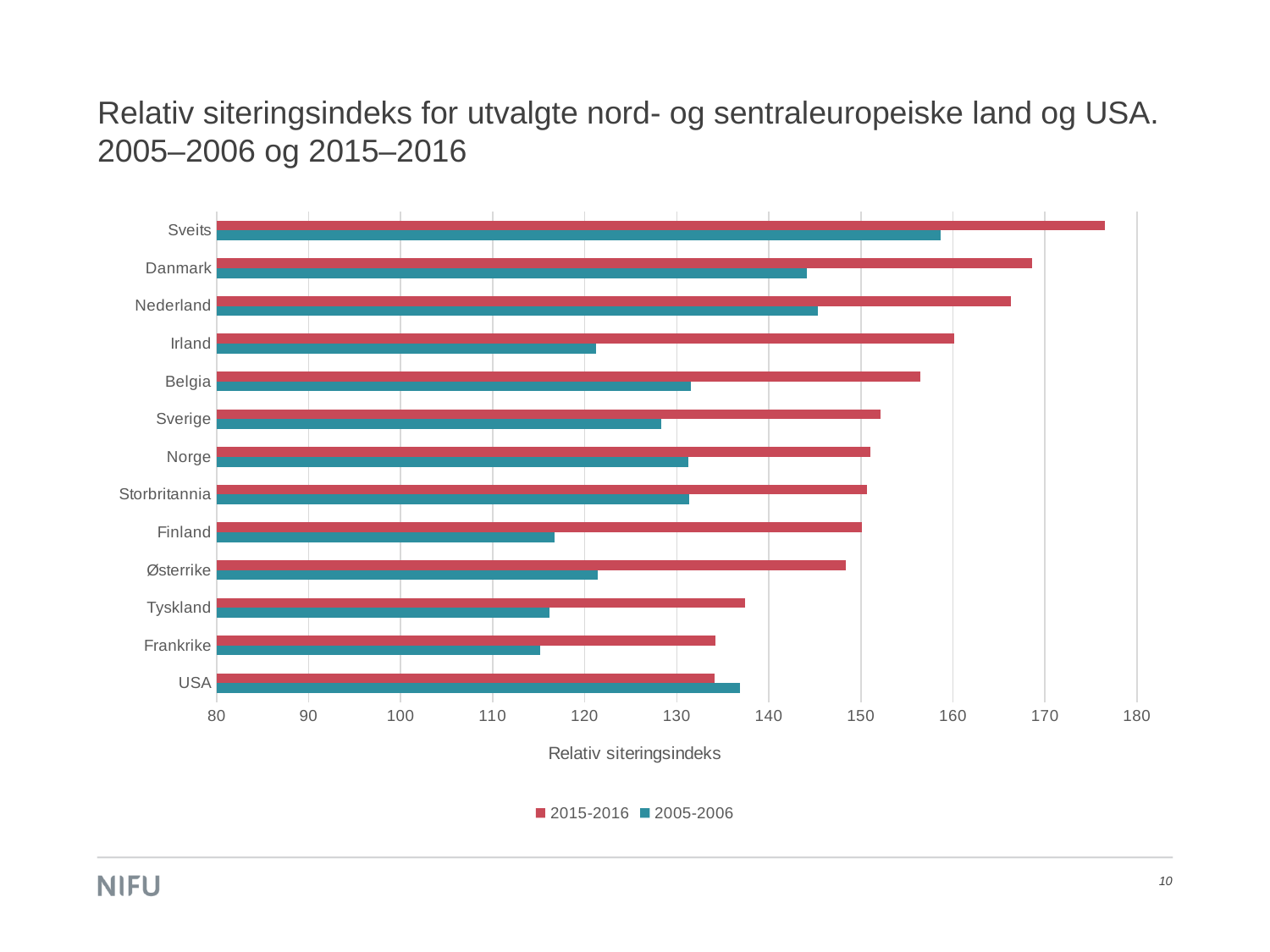
What is the title of the horizontal axis? Relativ siteringsindeks What kind of chart is shown on the slide? bar chart Is the 2005-2006 value for Danmark greater or less than 140? greater How many countries are listed on the chart? 13 Is the 2015-2016 value for Sveits greater or less than 170? greater Which country has the highest value for 2005-2006? Sveits Is the 2005-2006 value for Finland greater or less than 120? less How many series does the legend list? 2 Which country has the highest value for 2015-2016? Sveits Which is larger: the 2015-2016 value for Irland or the 2015-2016 value for Belgia? Irland For USA, which series has the larger value, 2015-2016 or 2005-2006? 2005-2006